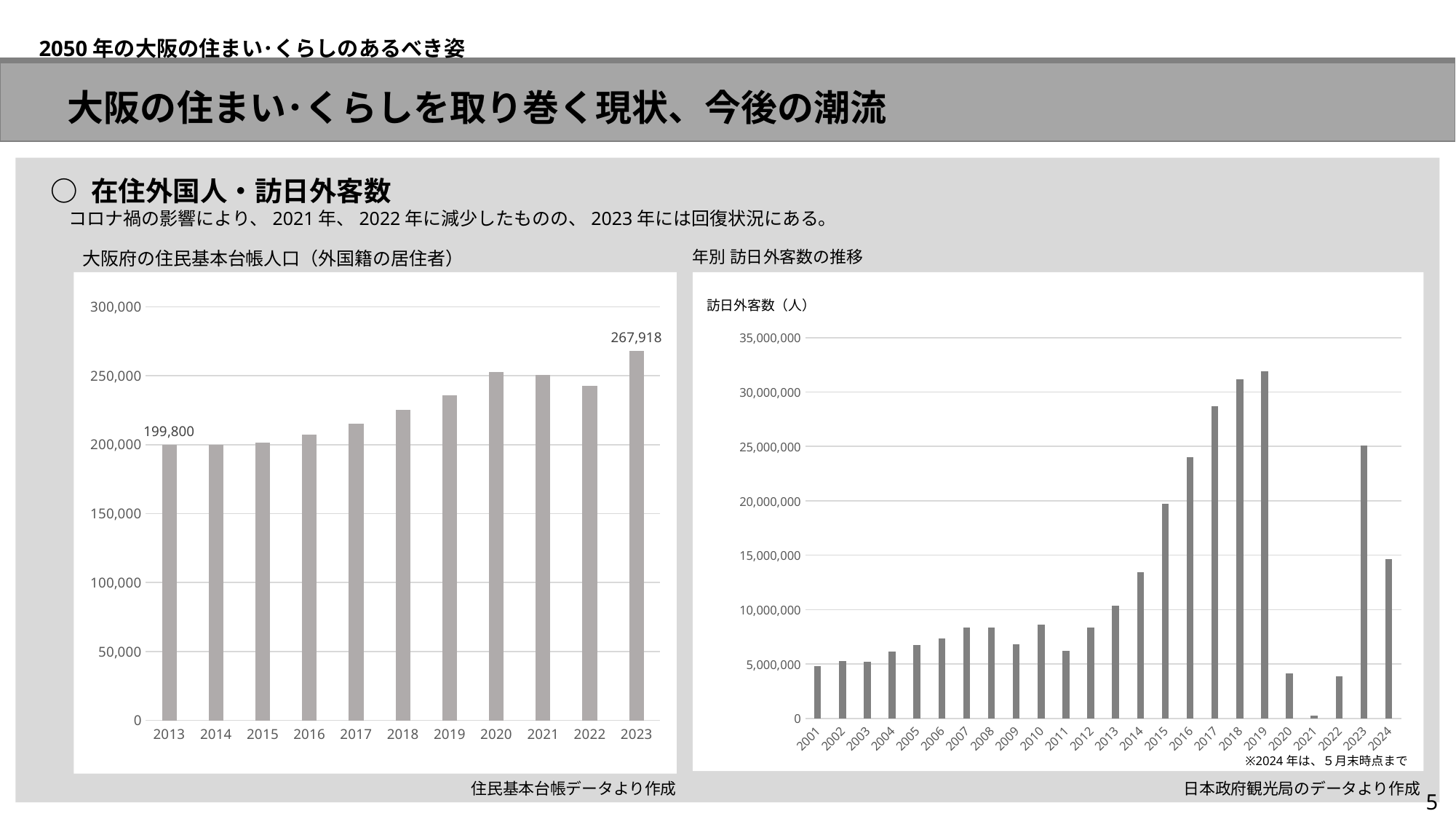
In the right chart (年別 訪日外客数の推移), is the value for 2023 greater or less than 20,000,000? greater In the left chart (大阪府の住民基本台帳人口（外国籍の居住者）), what is the difference between the 2023 value and the 2013 value? 68,118 In the left chart (大阪府の住民基本台帳人口（外国籍の居住者）), how many years are plotted? 11 In the right chart (年別 訪日外客数の推移), how many years are plotted? 24 In the left chart (大阪府の住民基本台帳人口（外国籍の居住者）), what is the value for 2013? 199,800 In the right chart (年別 訪日外客数の推移), which year has the highest value? 2019 In the right chart (年別 訪日外客数の推移), which year has the lowest value? 2021 In the left chart (大阪府の住民基本台帳人口（外国籍の居住者）), is the value for 2018 greater or less than 250,000? less In the left chart (大阪府の住民基本台帳人口（外国籍の居住者）), which is larger, the value for 2021 or the value for 2022? 2021 In the left chart (大阪府の住民基本台帳人口（外国籍の居住者）), which year has the highest value? 2023 What kind of chart is the right chart (年別 訪日外客数の推移)? bar chart In the left chart (大阪府の住民基本台帳人口（外国籍の居住者）), what is the value for 2023? 267,918